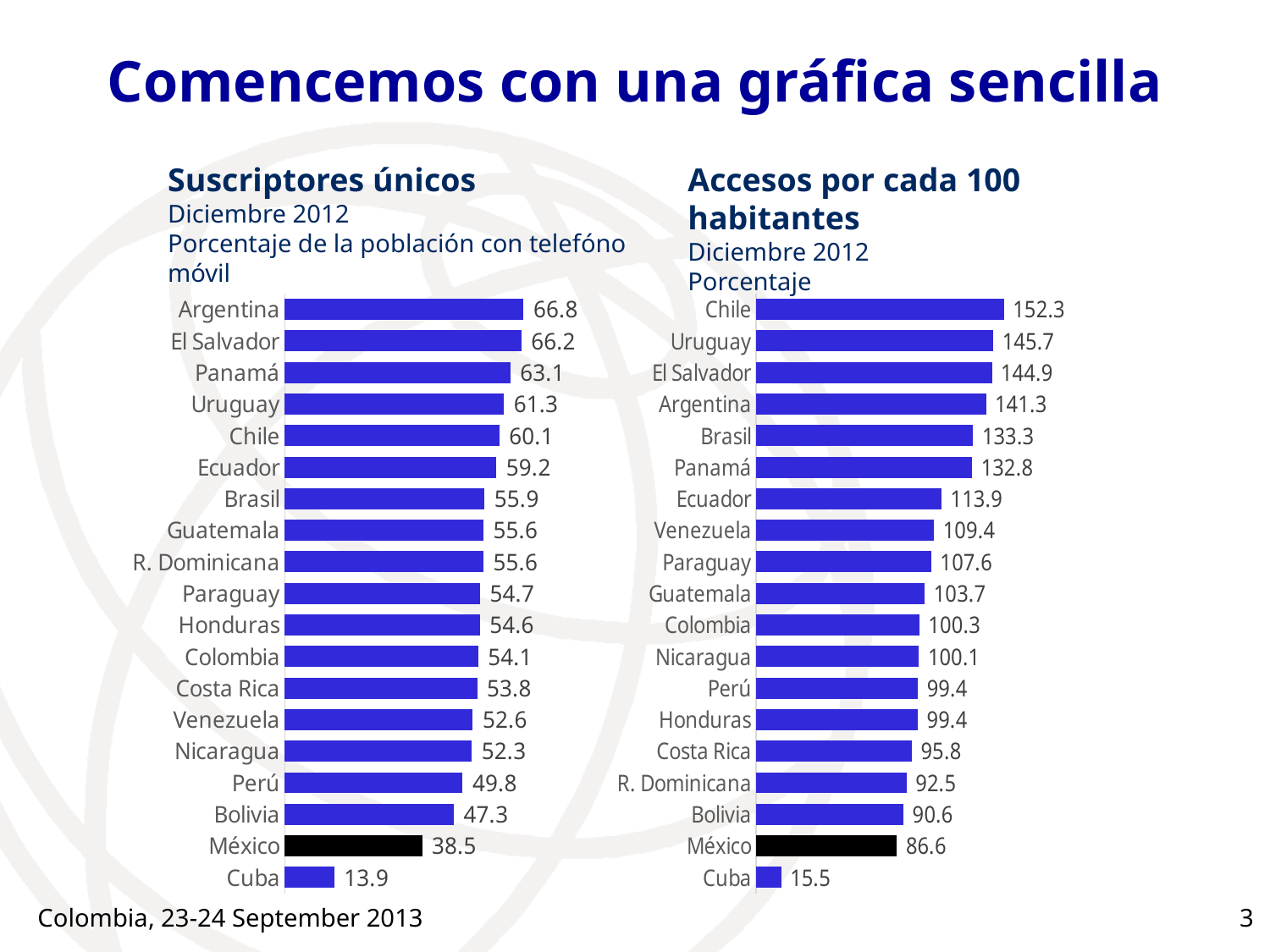
In the 'Accesos por cada 100 habitantes' chart, which is larger, the value for Ecuador or the value for Bolivia? Ecuador In the 'Suscriptores únicos' chart, which country has the lowest value? Cuba How many countries are shown in the 'Suscriptores únicos' chart? 19 In the 'Accesos por cada 100 habitantes' chart, what is the difference between the values for Chile and México? 65.7 In the 'Accesos por cada 100 habitantes' chart, which country's bar is coloured black instead of blue? México In the 'Suscriptores únicos' chart, what is the value for Argentina? 66.8 In the 'Accesos por cada 100 habitantes' chart, what is the value for Chile? 152.3 What type of chart is the 'Accesos por cada 100 habitantes' chart? Bar chart In the 'Suscriptores únicos' chart, what is the value for México? 38.5 In the 'Suscriptores únicos' chart, which is larger, the value for Panamá or the value for Perú? Panamá In the 'Suscriptores únicos' chart, what is the difference between the values for Argentina and Cuba? 52.9 In the 'Accesos por cada 100 habitantes' chart, which country has the highest value? Chile